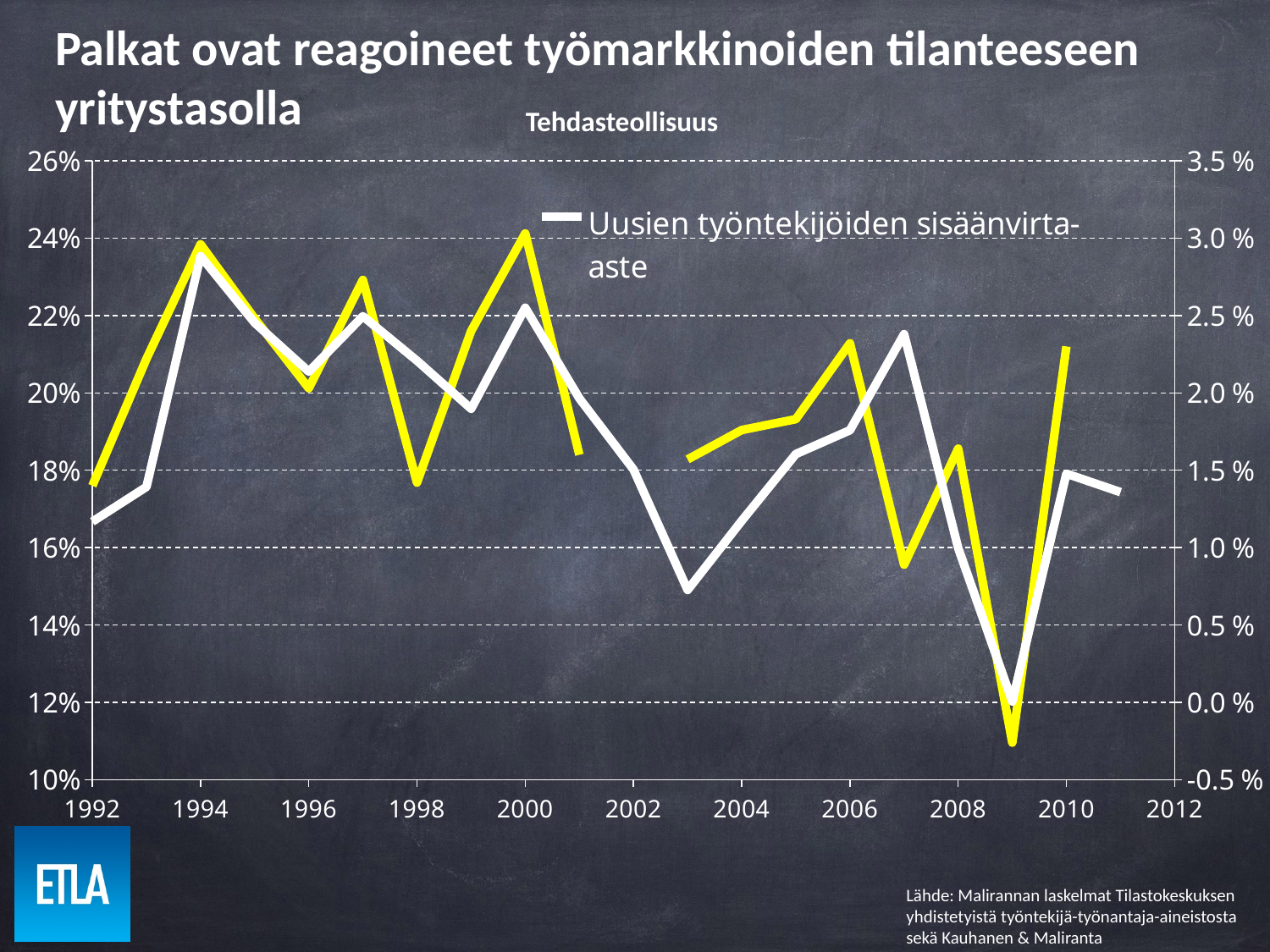
What colour is the line for 'Uusien työntekijöiden sisäänvirta-aste'? white Is the value of the white line (Uusien työntekijöiden sisäänvirta-aste) in 2007 greater or less than 20%? greater How many series does the chart's legend list? 1 On the right-hand axis, is the value of the yellow line in 2009 greater or less than 0.0 %? less In which year does the white line (Uusien työntekijöiden sisäänvirta-aste) reach its lowest value? 2009 On the right-hand axis, is the value of the yellow line in 2006 greater or less than 2.0 %? greater Does the white line (Uusien työntekijöiden sisäänvirta-aste) rise or fall between 2007 and 2009? fall What is the title of the chart? Tehdasteollisuus What kind of chart is shown on the slide? line chart